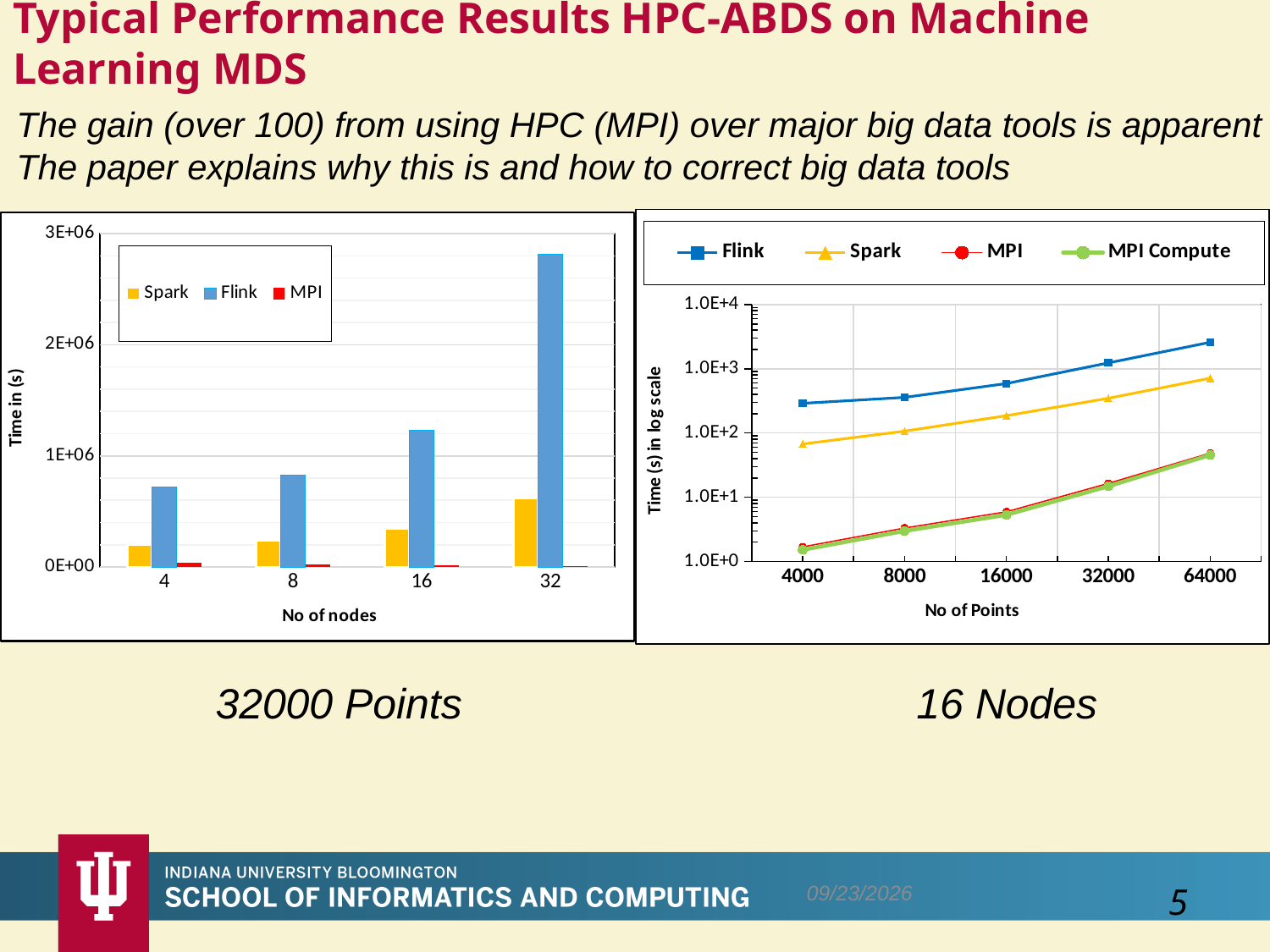
What kind of chart is the right chart? line chart On the right chart, how many series does the legend list? 4 On the left chart, which series has the lowest bars across all node counts? MPI On the right chart, is the Flink value at 64000 points greater or less than 1.0E+3? greater On the right chart, is the Spark value at 4000 points greater or less than 1.0E+2? less On the right chart, how many values of No of Points are shown on the x axis? 5 On the left chart, is the Flink value at 32 nodes greater or less than 2E+06? greater On the left chart, how many series does the legend list? 3 On the left chart, how many node counts are shown on the x axis? 4 On the right chart, does the Flink line rise or fall as the number of points increases? rises On the left chart, which series has the tallest bar at 32 nodes? Flink What kind of chart is the left chart? bar chart